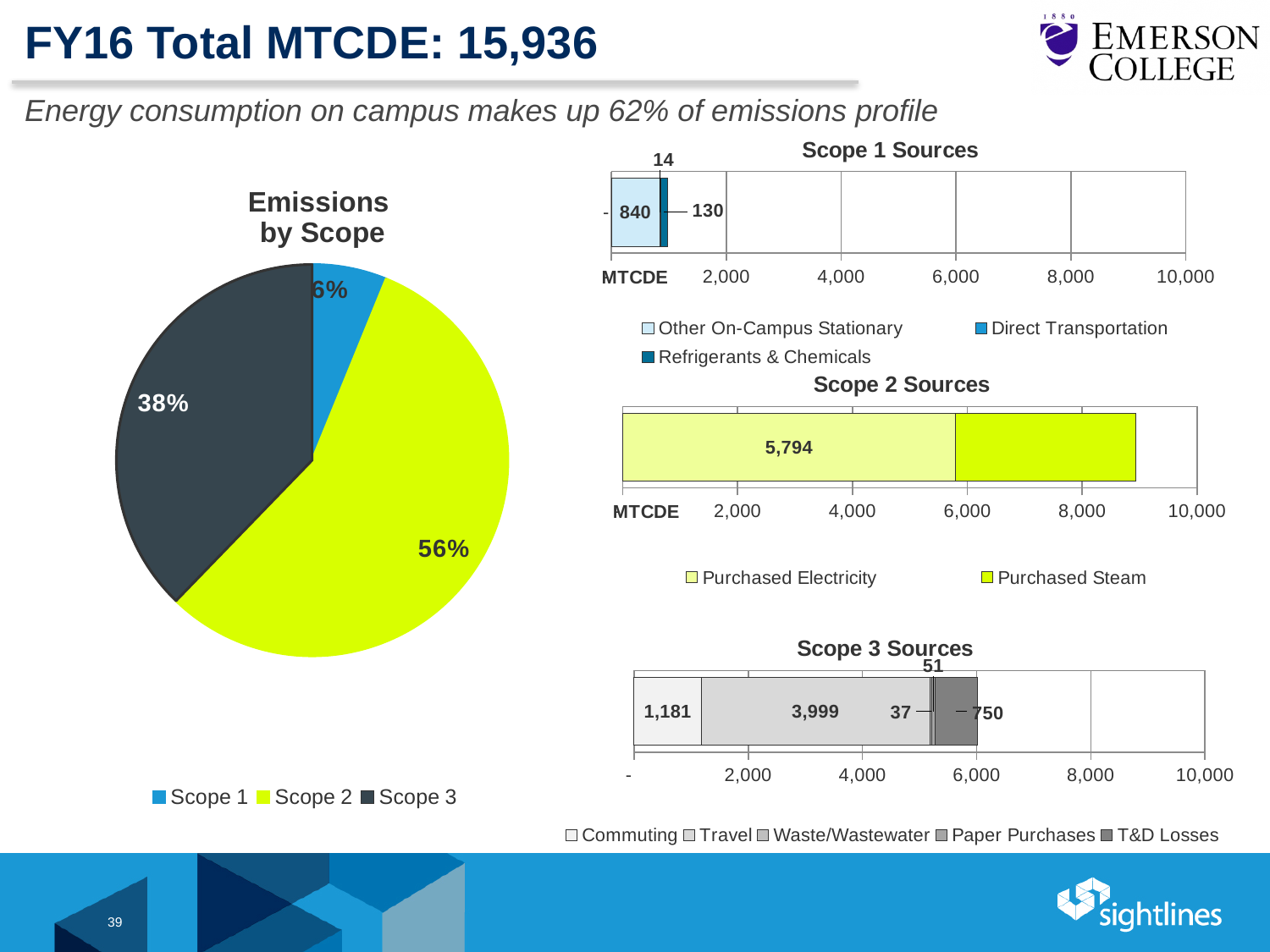
In the Emissions by Scope pie chart, what share of emissions is Scope 2? 56% In the Emissions by Scope pie chart, which scope has the largest share? Scope 2 How many series does the legend of the Scope 3 Sources chart list? 5 In the Scope 2 Sources chart, is the value for Purchased Steam greater or less than 2,000? greater How many series does the legend of the Scope 1 Sources chart list? 3 In the Emissions by Scope pie chart, which scope has the smallest share? Scope 1 In the Scope 3 Sources chart, what is the difference between Travel and Commuting? 2,818 In the Scope 1 Sources chart, what is the MTCDE value for Other On-Campus Stationary? 840 In the Scope 2 Sources chart, what is the MTCDE value for Purchased Electricity? 5,794 What kind of chart is the Emissions by Scope chart? Pie chart In the Scope 1 Sources chart, what is the total MTCDE of the stacked bar? 984 In the Scope 3 Sources chart, what is the MTCDE value for Travel? 3,999